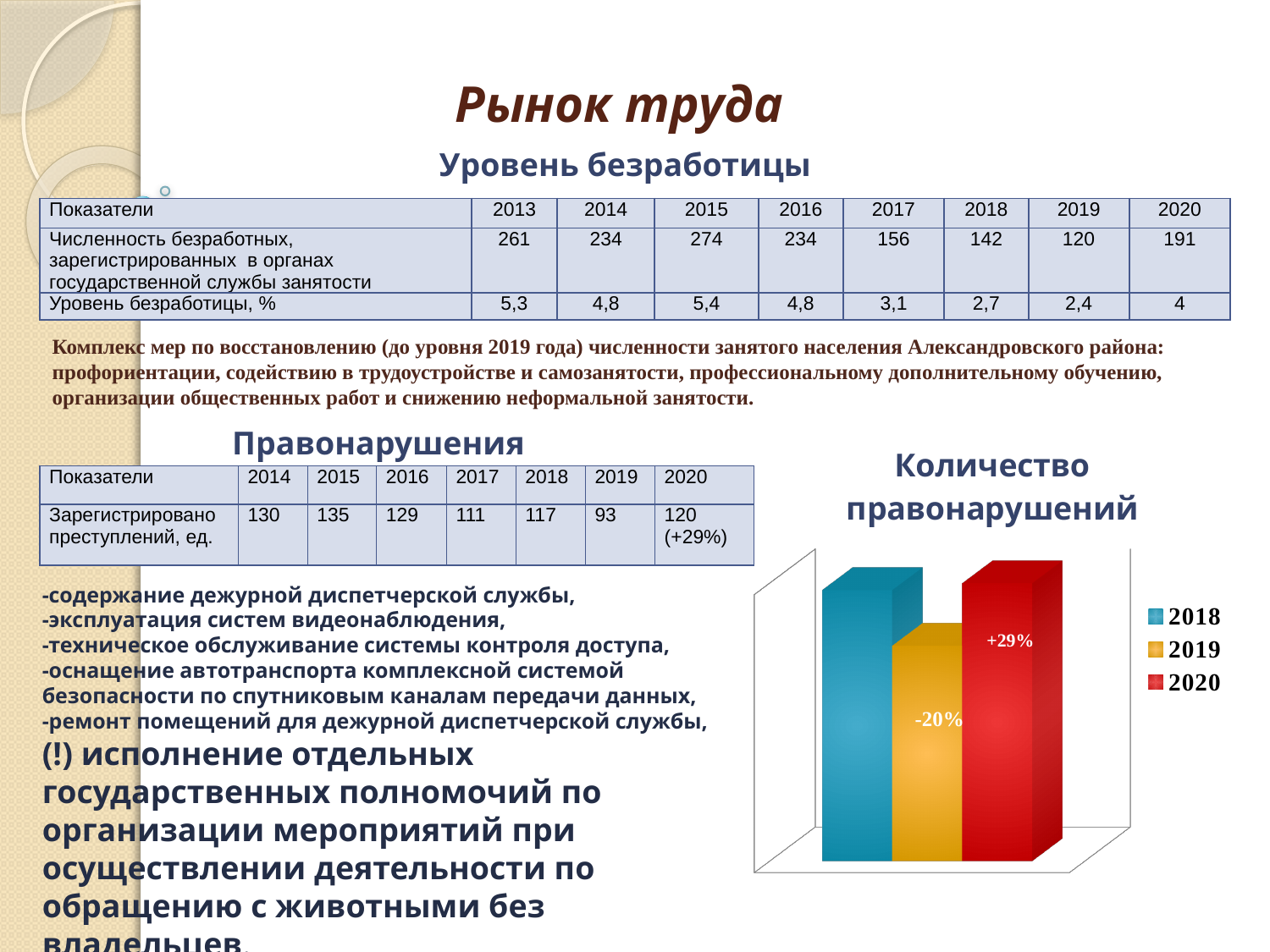
How many bars are plotted in the "Количество правонарушений" chart? 3 How many series does the legend of the "Количество правонарушений" chart list? 3 What colour is the 2020 bar in the "Количество правонарушений" chart? red What data label is printed on the 2020 bar in the "Количество правонарушений" chart? +29% Which years are listed in the legend of the "Количество правонарушений" chart? 2018, 2019, 2020 What kind of chart is shown under the title "Количество правонарушений"? bar chart In the "Количество правонарушений" chart, which year has the lowest bar? 2019 In the "Количество правонарушений" chart, is the bar for 2018 taller or shorter than the bar for 2019? taller What data label is printed on the 2019 bar in the "Количество правонарушений" chart? -20% In the "Количество правонарушений" chart, which bar is taller: 2019 or 2020? 2020